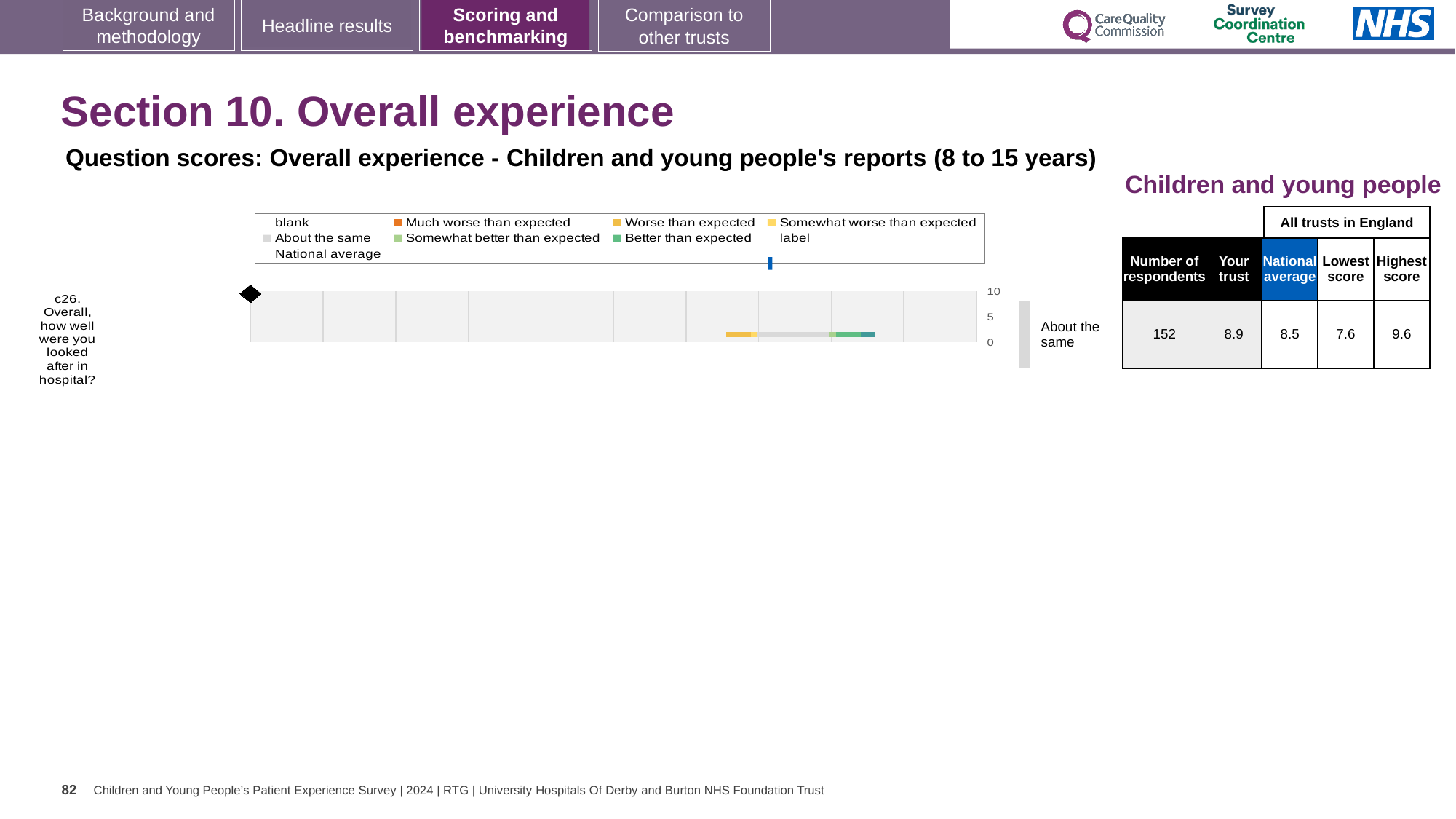
How many questions are plotted on the chart? 1 What is the difference between the 'Your trust' score and the national average for question c26? 0.4 What benchmark category label is shown to the right of the chart for question c26? About the same What kind of chart is used to show the question score for c26? Bar chart Is the 'Your trust' score for question c26 greater or less than 5 on the chart's axis? greater What is the difference between the highest and lowest trust scores for question c26? 2.0 What is the 'Your trust' score for question c26 'Overall, how well were you looked after in hospital?' 8.9 What is the national average score for question c26? 8.5 What is the highest score among all trusts in England for question c26? 9.6 Which is larger for question c26: the 'Your trust' score or the national average? Your trust How many respondents answered question c26? 152 What is the lowest score among all trusts in England for question c26? 7.6